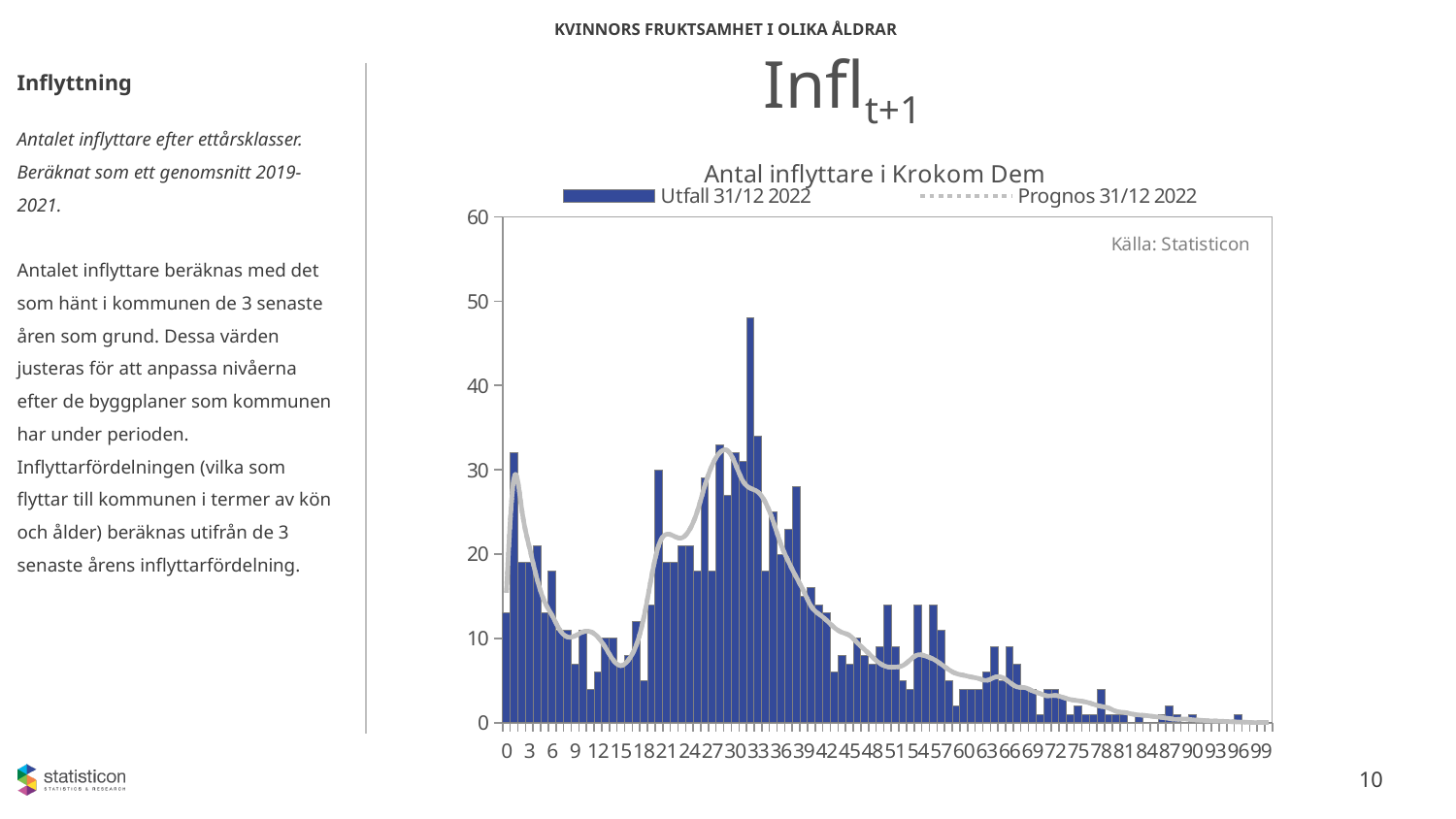
In the chart 'Antal inflyttare i Krokom Dem', is the tallest bar greater or less than 40? greater What is the title of the chart on the slide? Antal inflyttare i Krokom Dem In the chart 'Antal inflyttare i Krokom Dem', is the value for age 12 greater or less than 20? less In the chart 'Antal inflyttare i Krokom Dem', which has the larger value, age 0 or age 99? age 0 In the chart 'Antal inflyttare i Krokom Dem', is the value for age 60 greater or less than 20? less What are the two legend entries in the chart 'Antal inflyttare i Krokom Dem'? Utfall 31/12 2022 and Prognos 31/12 2022 How many series does the legend of the chart 'Antal inflyttare i Krokom Dem' list? 2 In the chart 'Antal inflyttare i Krokom Dem', do the values generally rise or fall from age 60 to age 99? fall What kind of chart is 'Antal inflyttare i Krokom Dem'? combination bar and line chart